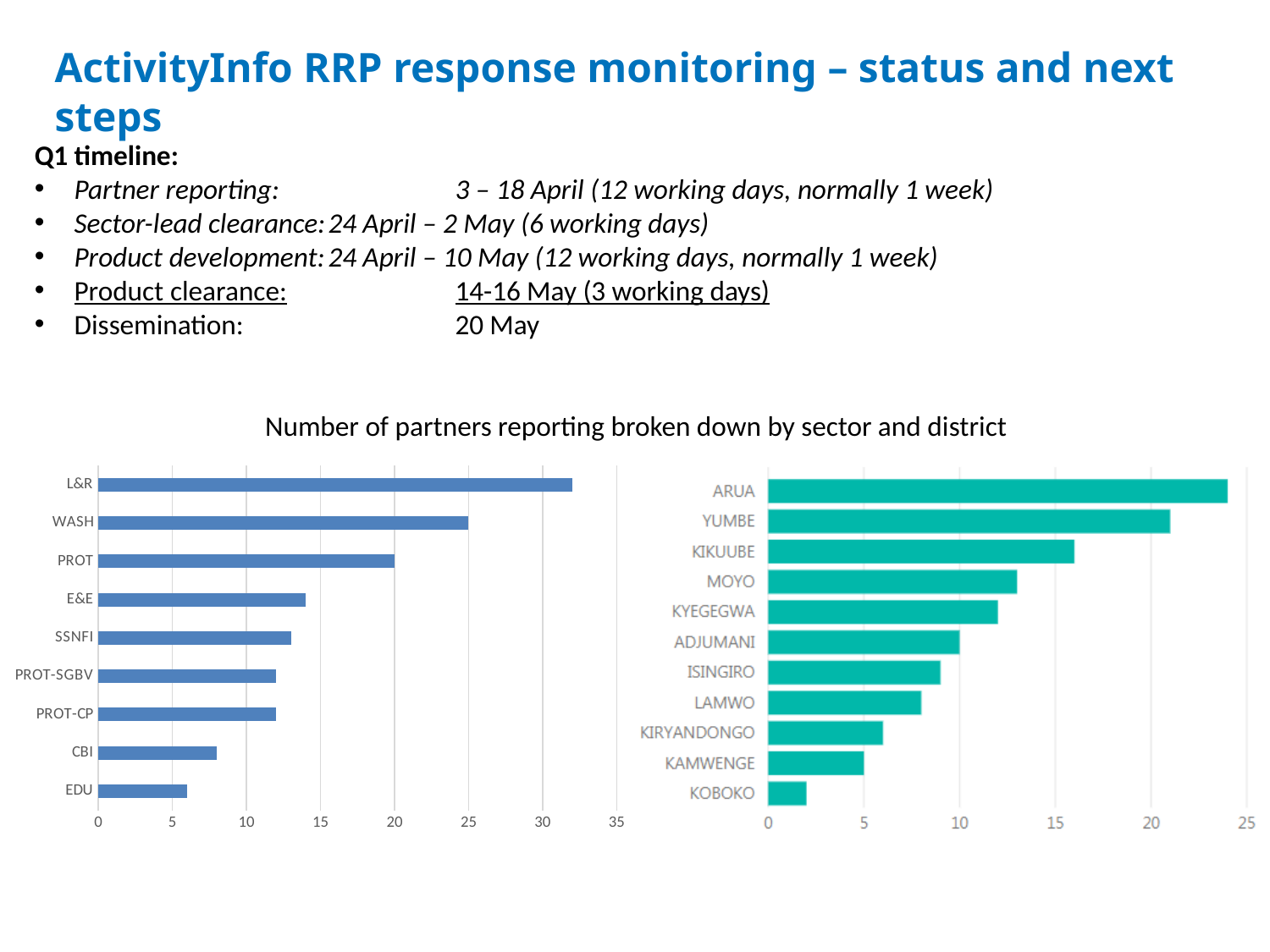
In the left chart (sectors), which sector has the highest number of partners reporting? L&R In the right chart (districts), which has more partners reporting, YUMBE or KIKUUBE? YUMBE In the left chart (sectors), which sector has the lowest number of partners reporting? EDU In the left chart (sectors), is the value for L&R greater or less than 30? greater In the right chart (districts), is the value for KIKUUBE greater or less than 15? greater What kind of chart is the left chart showing sectors? bar chart In the right chart (districts), which district has the highest number of partners reporting? ARUA In the right chart (districts), how many districts are shown? 11 What is the title shown above the two charts? Number of partners reporting broken down by sector and district In the right chart (districts), which district has the lowest number of partners reporting? KOBOKO In the left chart (sectors), how many sectors are shown? 9 In the left chart (sectors), what is the value for WASH? 25